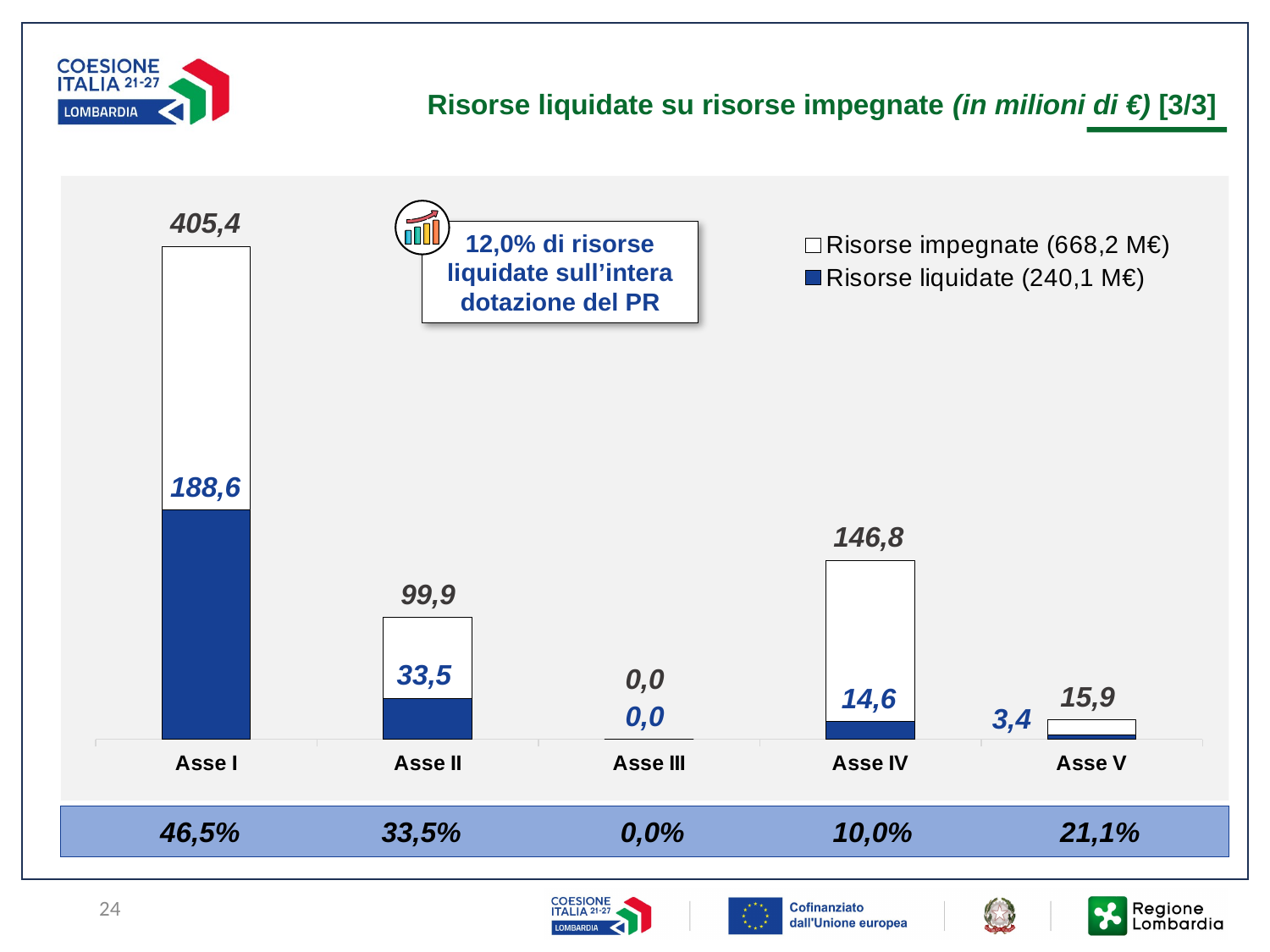
What is the value of Risorse impegnate for Asse I? 405,4 What is the value of Risorse liquidate for Asse IV? 14,6 What is the difference between Risorse impegnate and Risorse liquidate for Asse IV? 132,2 Which is larger: Risorse impegnate for Asse II or Risorse impegnate for Asse IV? Asse IV How many series does the legend list? 2 What is the value of Risorse impegnate for Asse V? 15,9 Which Asse has the lowest value of Risorse liquidate? Asse III What is the difference between Risorse impegnate and Risorse liquidate for Asse I? 216,8 Which Asse has the highest value of Risorse impegnate? Asse I What is the value of Risorse liquidate for Asse II? 33,5 What kind of chart is shown on the slide? Bar chart How many Asse categories are shown on the x axis? 5